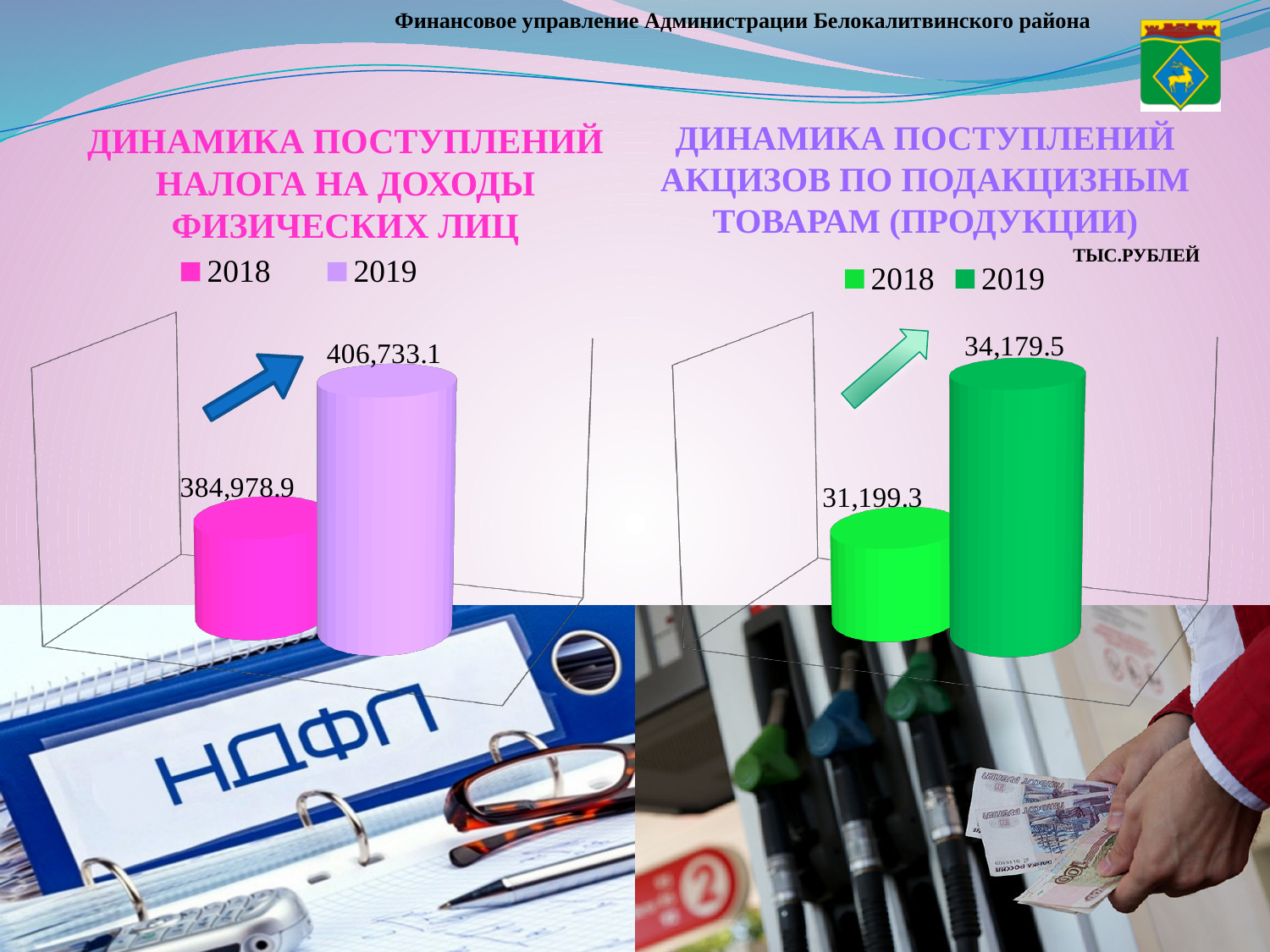
How many series does the legend of the left chart list? 2 On the right chart, what is the difference between the 2019 and 2018 values? 2,980.2 On the right chart (excise receipts), what is the value for 2019? 34,179.5 On the right chart, is the value for 2019 larger or smaller than the value for 2018? larger On the left chart (personal income tax receipts), what is the value for 2019? 406,733.1 On the left chart, what is the difference between the 2019 and 2018 values? 21,754.2 On the left chart, which year has the higher value? 2019 On the right chart (excise receipts), what is the value for 2018? 31,199.3 What kind of chart is the right chart? bar chart On the right chart, which year has the lower value? 2018 On the left chart (personal income tax receipts), what is the value for 2018? 384,978.9 What unit is stated for the right chart (excise receipts)? ТЫС.РУБЛЕЙ